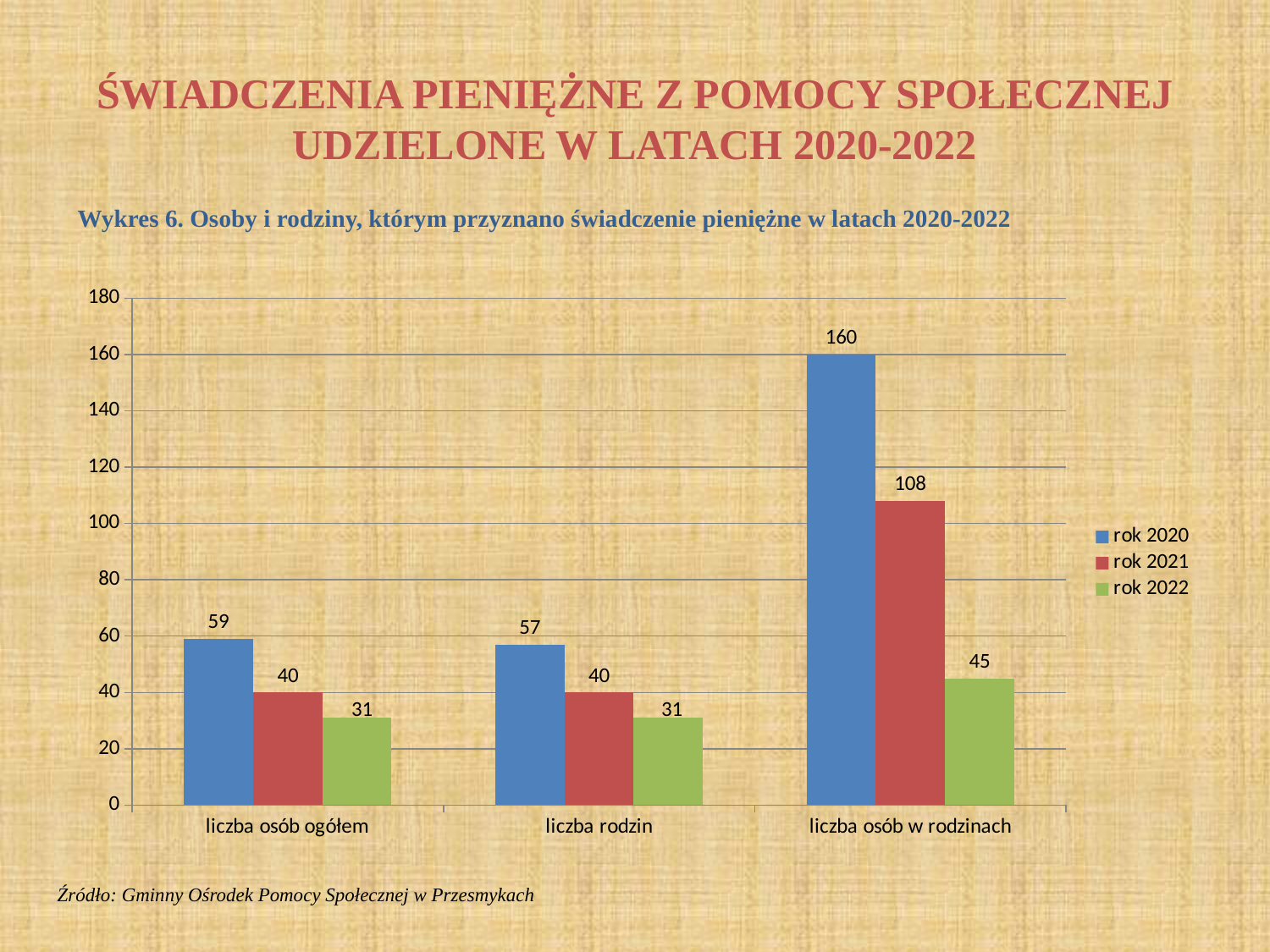
Do the values for 'liczba osób w rodzinach' rise or fall from 'rok 2020' to 'rok 2022'? fall What is the value for 'liczba osób ogółem' in the 'rok 2022' series? 31 Which category has the highest value in the 'rok 2021' series? liczba osób w rodzinach How many series does the legend list? 3 What is the value for 'liczba osób w rodzinach' in the 'rok 2020' series? 160 What is the difference between the 'rok 2020' and 'rok 2021' values for 'liczba osób w rodzinach'? 52 What kind of chart is shown on the slide? bar chart Which is larger: the 'rok 2020' value for 'liczba osób ogółem' or the 'rok 2020' value for 'liczba rodzin'? liczba osób ogółem How many categories are shown on the x axis? 3 What is the value for 'liczba rodzin' in the 'rok 2021' series? 40 Which series has the lowest value for 'liczba osób w rodzinach'? rok 2022 What is the difference between the 'rok 2020' and 'rok 2022' values for 'liczba osób ogółem'? 28